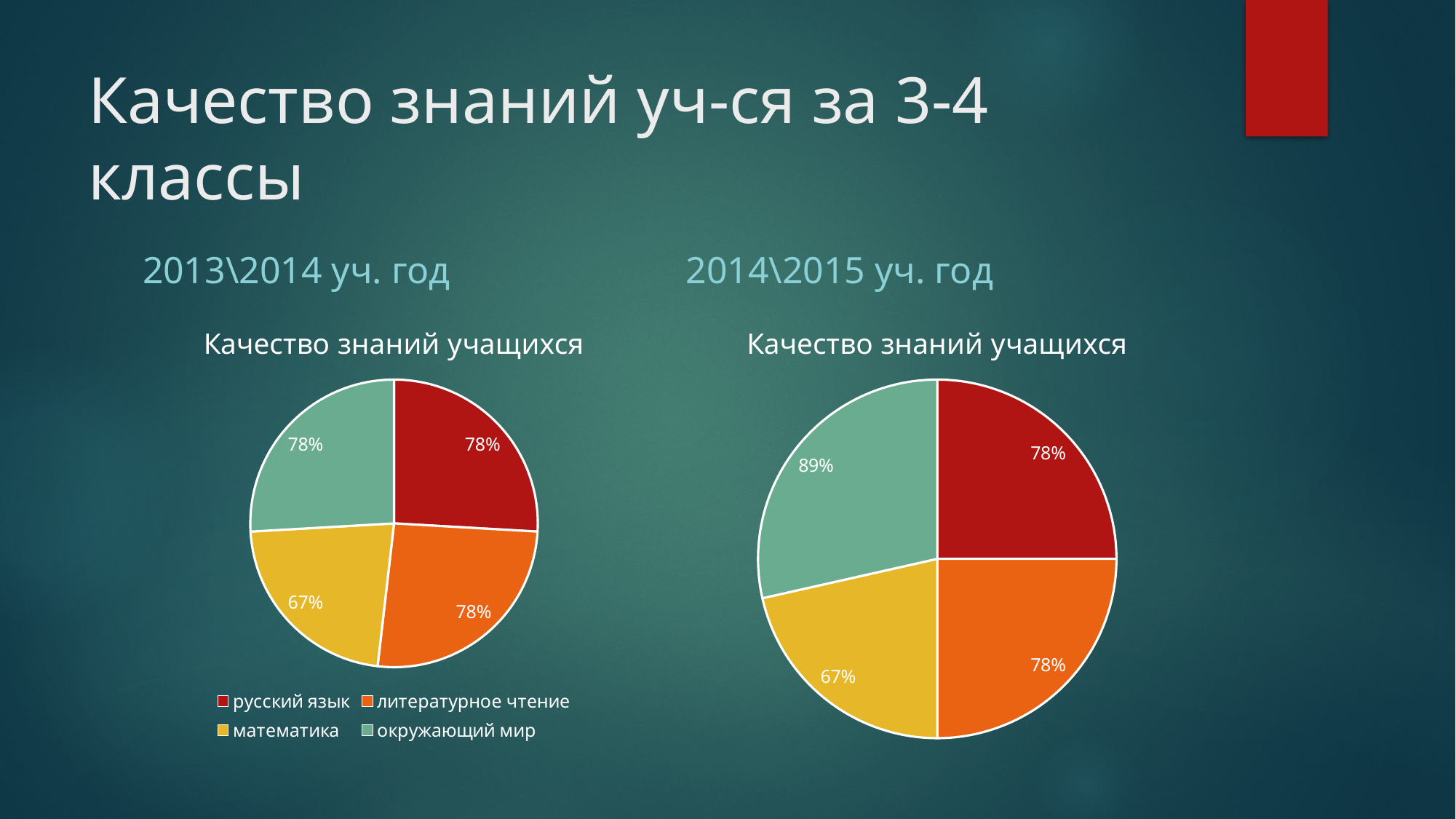
How many entries does the legend of the 2013\2014 уч. год chart list? 4 In the 2013\2014 уч. год chart, what is the value for математика? 67% In the 2014\2015 уч. год chart, what value is shown on the green slice? 89% In the 2014\2015 уч. год chart, which is larger: the value on the green slice or the value on the red slice? the green slice (89%) How many slices does the 2013\2014 уч. год pie chart have? 4 What type of chart is used on the slide for the 2014\2015 уч. год data? pie chart In the 2013\2014 уч. год chart, which category has the lowest value? математика In the 2013\2014 уч. год chart, what is the value for русский язык? 78% In the 2014\2015 уч. год chart, what is the difference between the largest value (89%) and the smallest value (67%)? 22% In the 2014\2015 уч. год chart, what value is shown on the yellow slice? 67% What is the title of the 2013\2014 уч. год chart? Качество знаний учащихся In the legend of the 2013\2014 уч. год chart, which colour represents окружающий мир? green